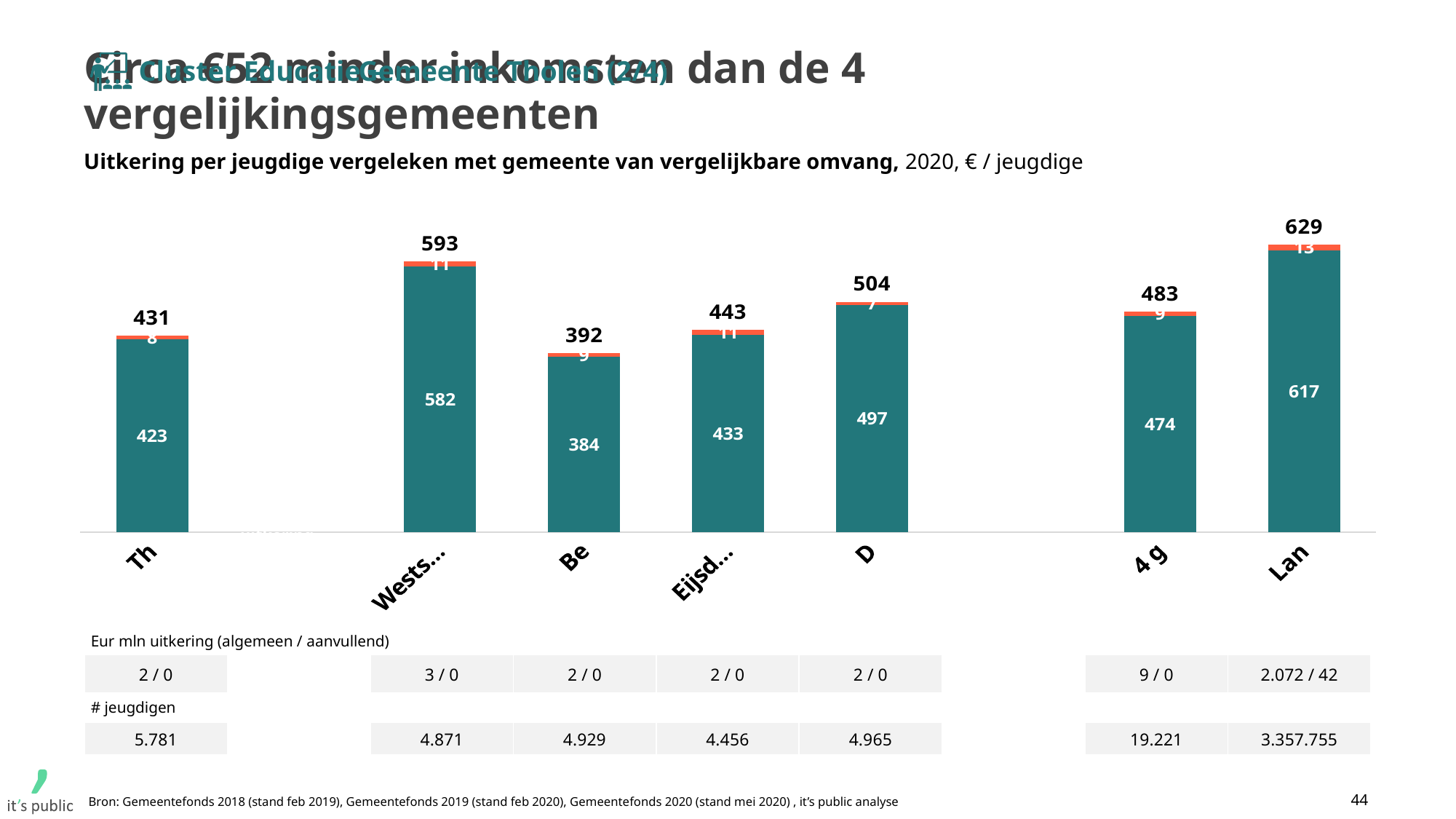
What is the total value shown above the bar for Th? 431 What is the difference between the total for Lan and the total for Th? 198 What kind of chart is shown on the slide? Stacked bar chart What is the value of the teal (lower) segment for 4 g? 474 What is the value of the teal (lower) segment for D? 497 Which category has the highest total value? Lan Which has a larger teal (lower) segment, Be or Eijsd...? Eijsd... What is the total value shown above the bar for Eijsd...? 443 Which category has the lowest total value? Be What is the difference between the total for 4 g and the total for Be? 91 How many bars are shown in the chart? 7 Which has a larger total, Wests... or D? Wests...